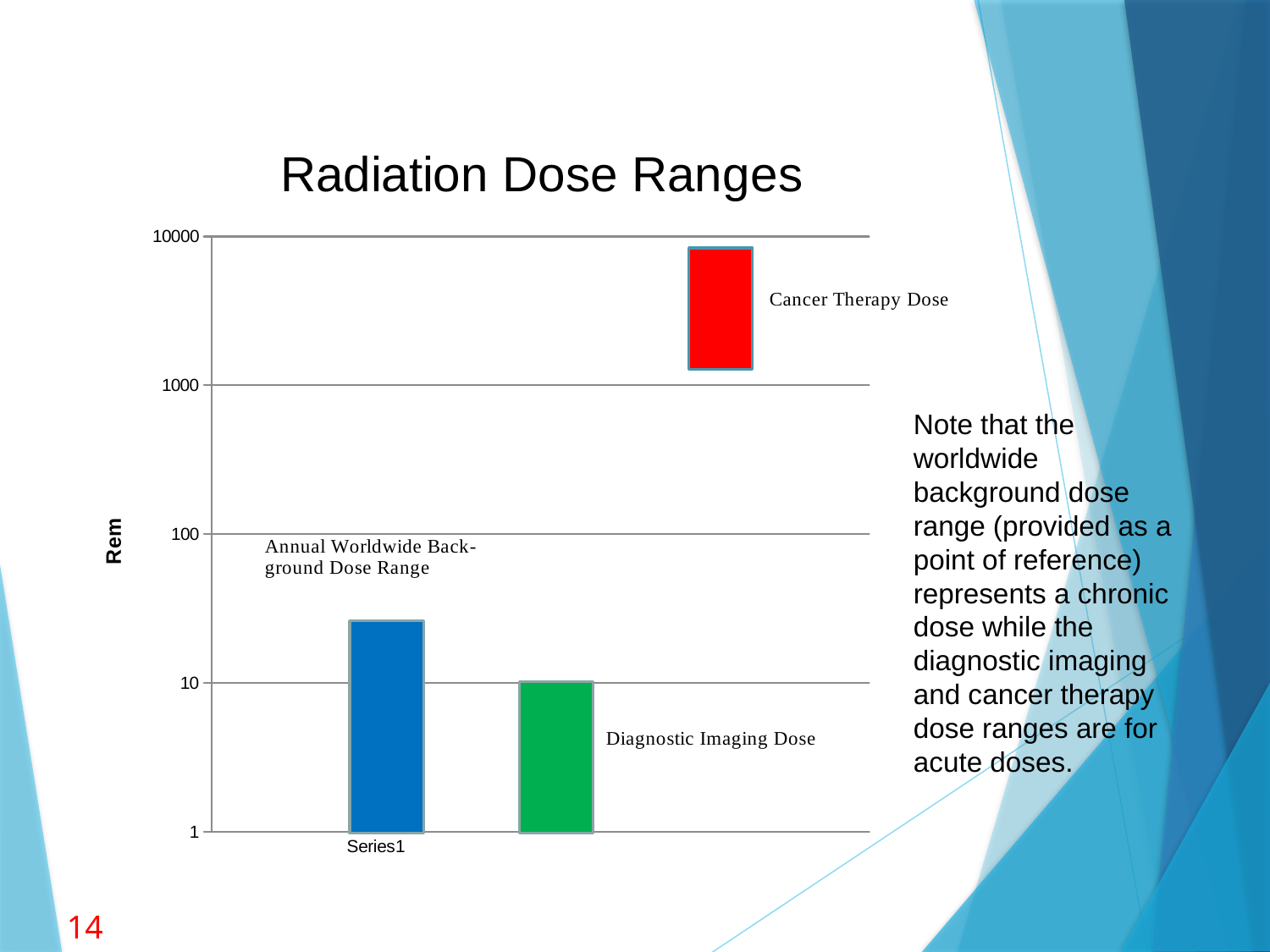
What is the label on the vertical axis of the chart? Rem Which dose range has the lowest top value on the chart? Diagnostic Imaging Dose What kind of chart is shown on the slide? bar chart How many bars are plotted in the chart? 3 Is the top of the Annual Worldwide Background Dose Range bar greater or less than 10? greater Which is larger, the Cancer Therapy Dose or the Annual Worldwide Background Dose Range? Cancer Therapy Dose Which dose range reaches the highest value on the chart? Cancer Therapy Dose Is the top of the Cancer Therapy Dose bar greater or less than 10000? less What value does the top of the Diagnostic Imaging Dose bar reach on the Rem axis? 10 What is the title of the chart? Radiation Dose Ranges Is the bottom of the Cancer Therapy Dose bar greater or less than 1000? greater